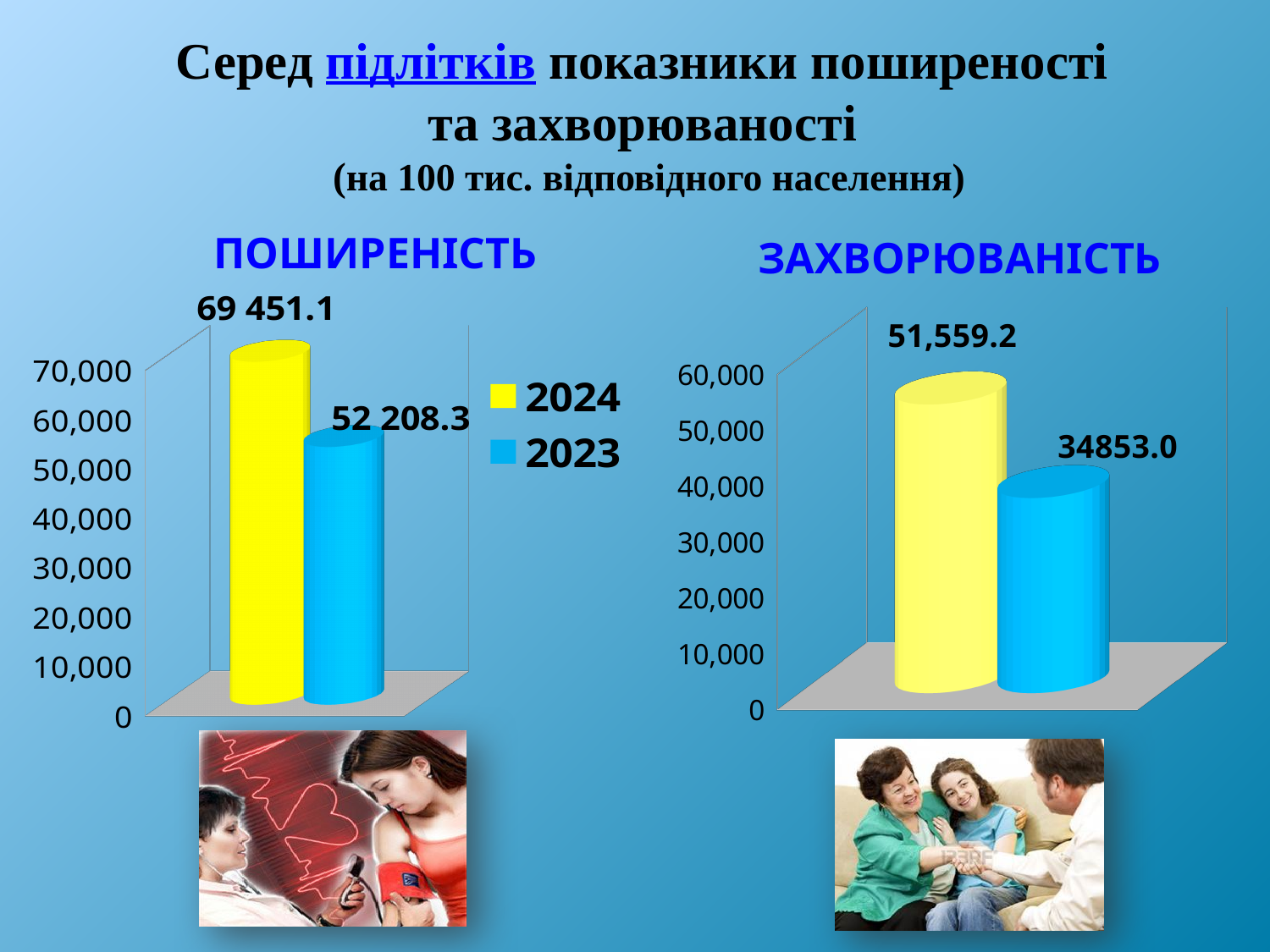
In the ПОШИРЕНІСТЬ chart, what is the value for 2024? 69 451.1 What kind of chart is the ПОШИРЕНІСТЬ chart? bar chart In the legend on the slide, which colour represents 2024? yellow In the ПОШИРЕНІСТЬ chart, which year has the higher value? 2024 In the ПОШИРЕНІСТЬ chart, what is the difference between the 2024 and 2023 values? 17 242.8 In the ПОШИРЕНІСТЬ chart, what is the value for 2023? 52 208.3 How many series does the legend on the slide list? 2 In the ЗАХВОРЮВАНІСТЬ chart, what is the value for 2024? 51,559.2